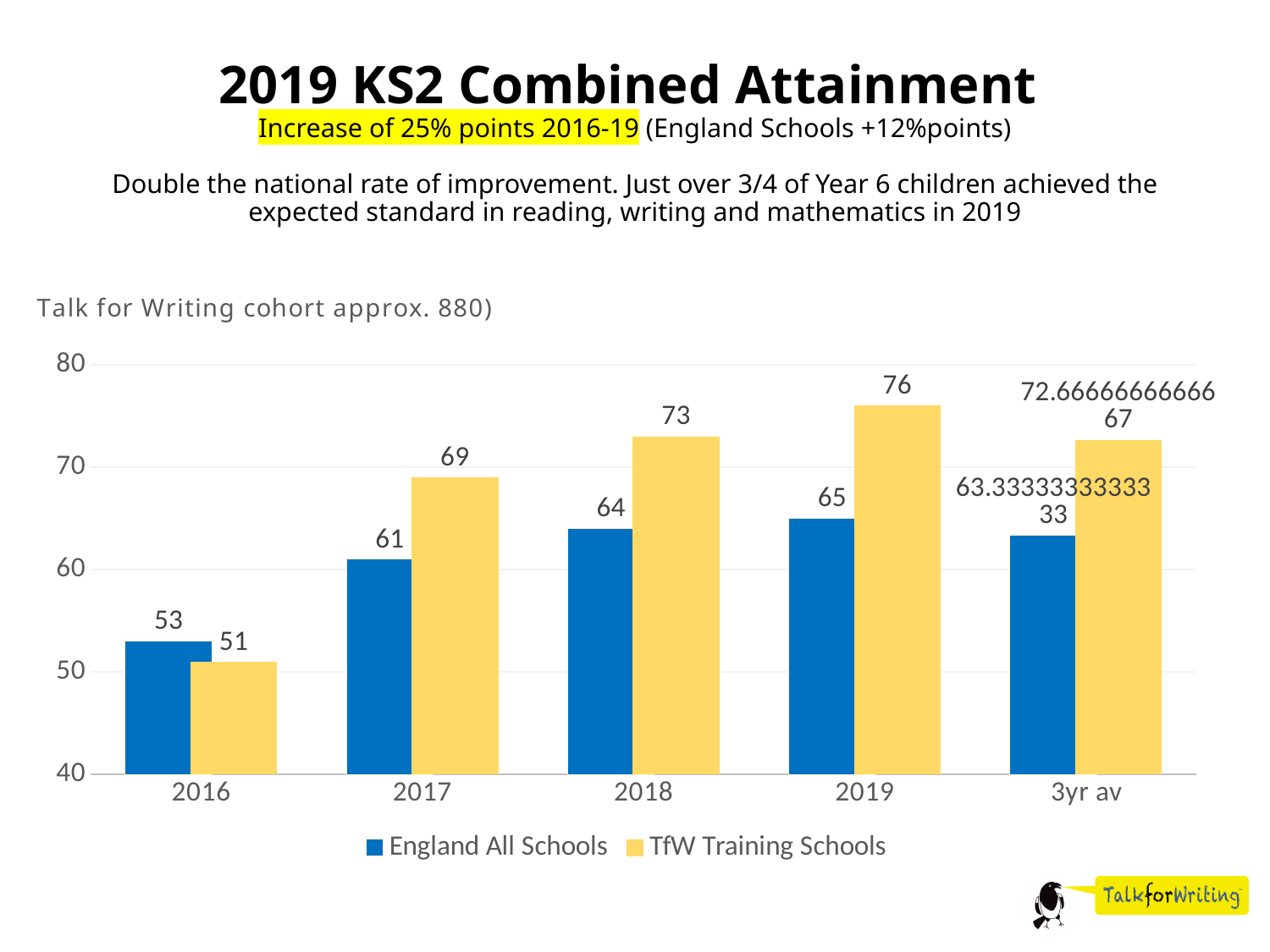
Is the value for TfW Training Schools in the 3yr av category greater or less than 70? greater In which year is the England All Schools value lowest? 2016 What is the value for TfW Training Schools in 2016? 51 Do the TfW Training Schools values rise or fall from 2016 to 2019? rise What is the value for England All Schools in 2017? 61 Which is larger in 2016, England All Schools or TfW Training Schools? England All Schools How many categories are shown on the x axis? 5 In which year is the TfW Training Schools value highest? 2019 What is the difference between TfW Training Schools and England All Schools in 2018? 9 What type of chart is shown on the slide? bar chart How many series does the legend list? 2 What is the value for TfW Training Schools in 2019? 76